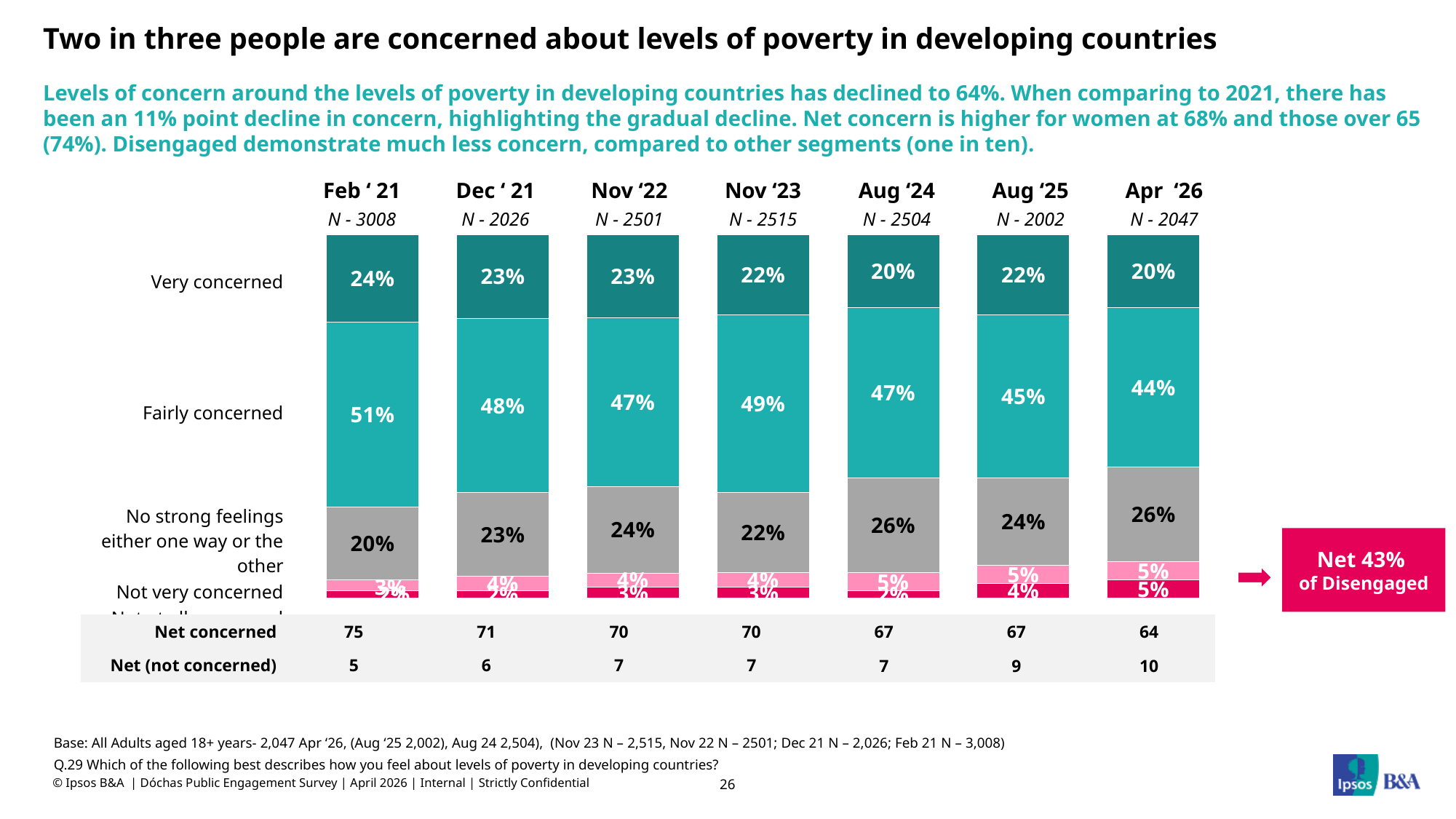
In which survey wave was the 'Fairly concerned' share highest? Feb '21 In which survey wave was the 'Fairly concerned' share lowest? Apr '26 What percentage of respondents were 'Very concerned' in Feb '21? 24% By how many percentage points did the 'Fairly concerned' share fall from Feb '21 to Apr '26? 7 percentage points What type of chart is used on this slide? Stacked bar chart What percentage had 'No strong feelings either one way or the other' in Aug '24? 26% What percentage of respondents were 'Fairly concerned' in Apr '26? 44% How many survey waves are shown in the chart? 7 What is the sample size (N) shown for the Nov '22 wave? 2501 What is the 'Net concerned' figure for Apr '26? 64 Which wave had a higher 'Very concerned' share, Dec '21 or Nov '23? Dec '21 What is the 'Net (not concerned)' figure for Aug '25? 9